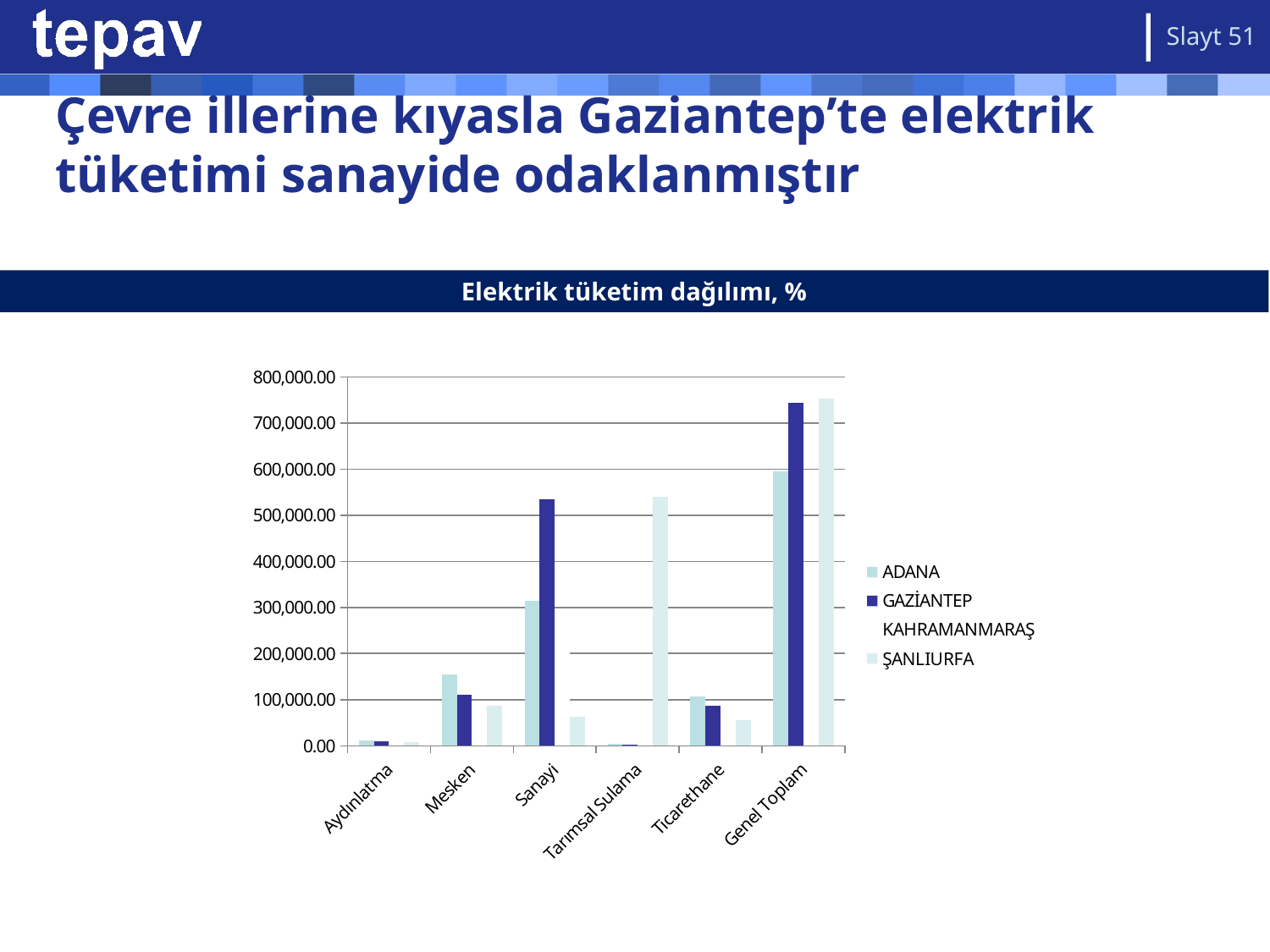
Is the ADANA value for Genel Toplam greater or less than 500,000.00? greater How many categories are shown on the x axis? 6 What kind of chart is shown on the slide? bar chart In which category is the GAZİANTEP bar the highest? Genel Toplam In which category is the ŞANLIURFA bar the lowest? Aydınlatma Is the GAZİANTEP value for Sanayi greater or less than 500,000.00? greater How many series does the legend list? 4 For Mesken, which is larger: the ADANA value or the GAZİANTEP value? ADANA For Sanayi, which is larger: the ADANA value or the GAZİANTEP value? GAZİANTEP Is the ADANA value for Sanayi greater or less than 400,000.00? less What is the title of the chart? Elektrik tüketim dağılımı, %